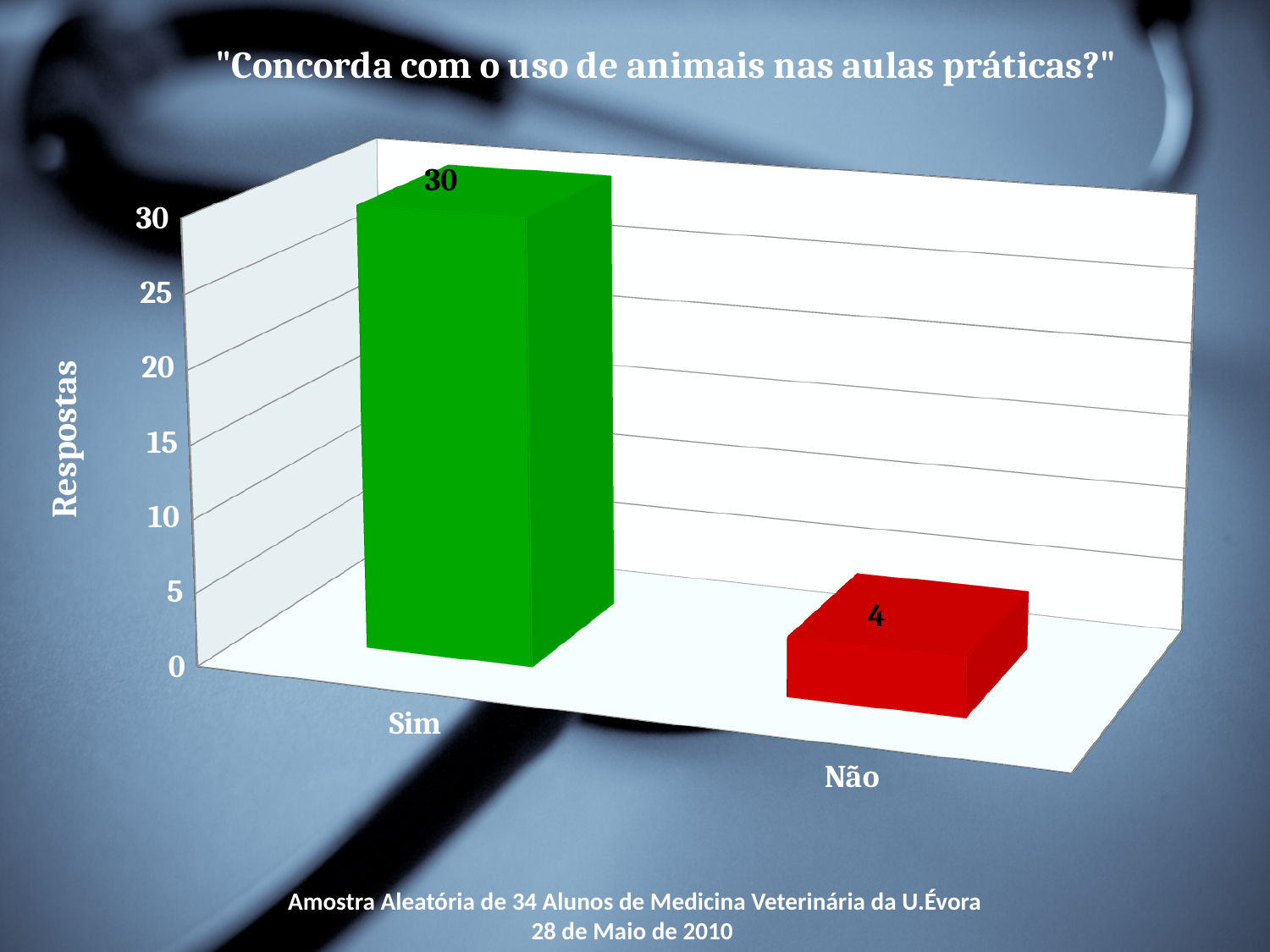
What is the difference between the values for "Sim" and "Não"? 26 What is the value for "Não"? 4 Which category has the highest value? Sim Which category has the lowest value? Não Is the value for "Não" greater or less than 5? less What kind of chart is shown on the slide? bar chart Is the value for "Sim" greater or less than 25? greater What is the title of the chart? "Concorda com o uso de animais nas aulas práticas?" What is the label of the vertical axis? Respostas How many categories are shown on the x axis? 2 What is the value for "Sim"? 30 Which is larger, the value for "Sim" or the value for "Não"? Sim